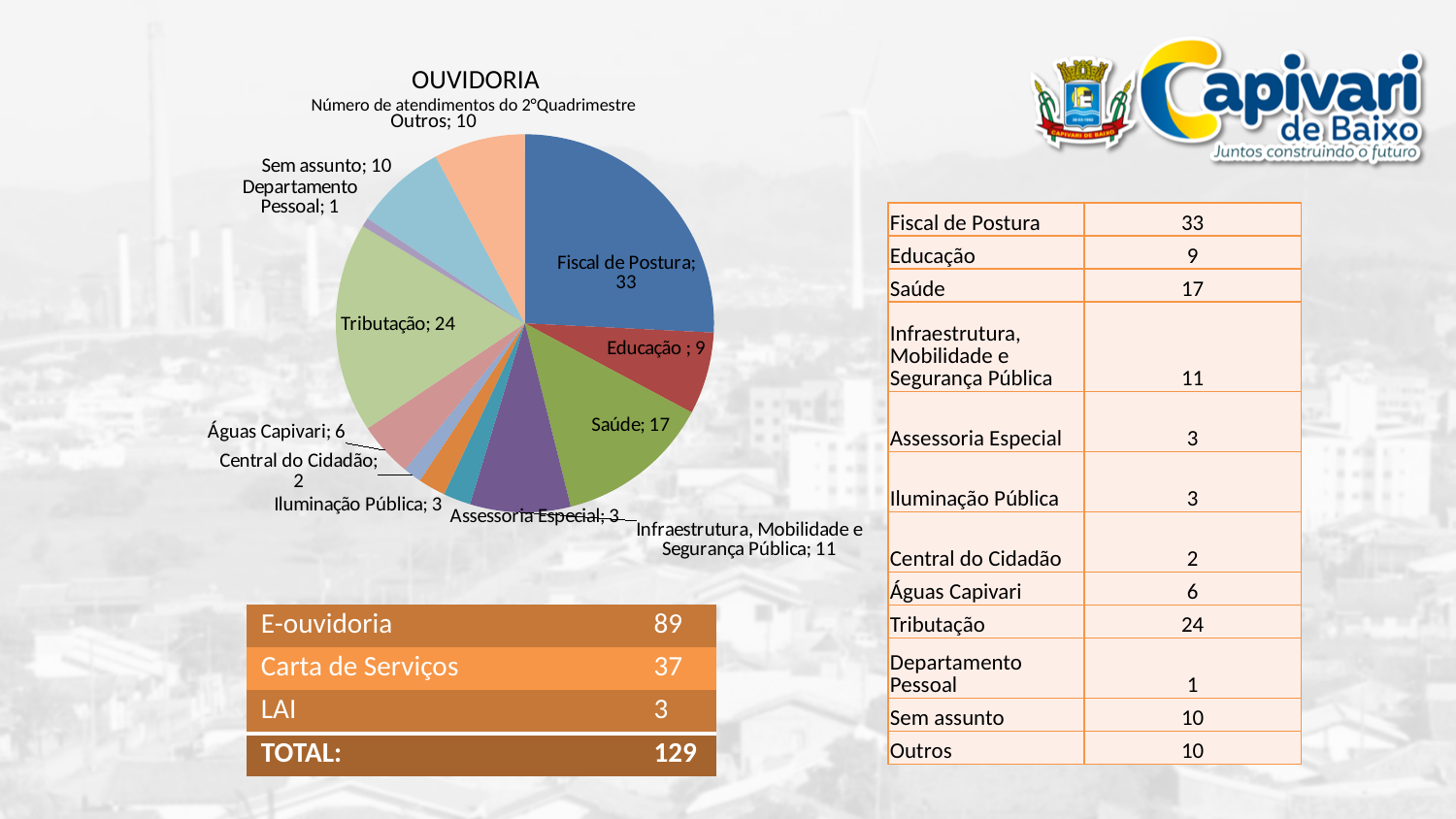
What is the value for Tributação in the pie chart? 24 What is the difference between the values for Fiscal de Postura and Tributação? 9 Which category has the smallest slice in the pie chart? Departamento Pessoal What is the value for Fiscal de Postura in the pie chart? 33 What is the total of all the values shown in the pie chart? 129 How many categories (slices) does the pie chart have? 12 What kind of chart is shown on the slide? Pie chart Which category has the largest slice in the pie chart? Fiscal de Postura What is the value for Águas Capivari in the pie chart? 6 Which is larger in the pie chart, Saúde or Educação? Saúde What is the value for Infraestrutura, Mobilidade e Segurança Pública in the pie chart? 11 What is the title of the chart? OUVIDORIA